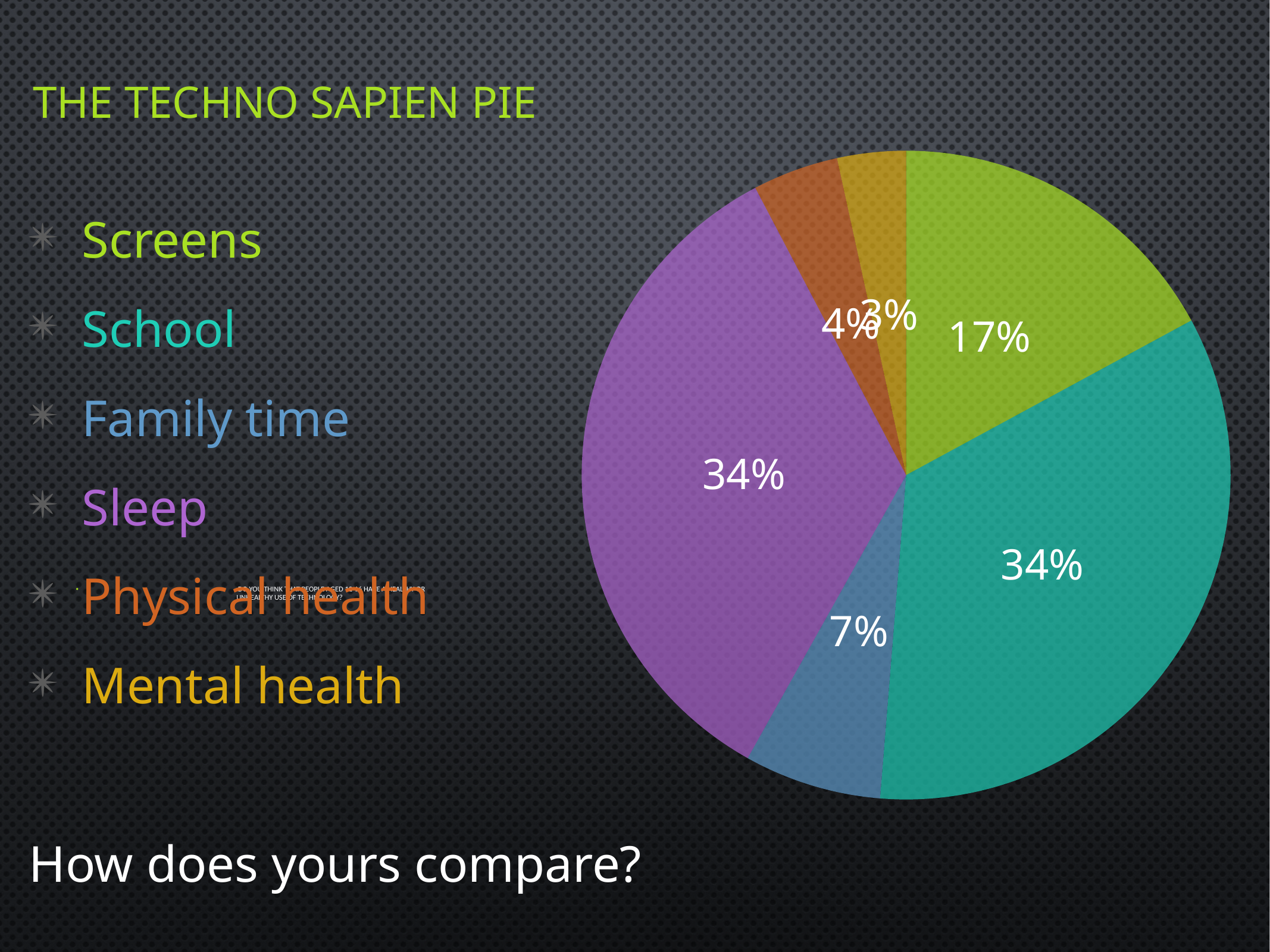
What is the difference between the Screens share and the Physical health share? 13% What kind of chart is shown on the slide? pie chart What share of the pie is Physical health? 4% Which is larger, the Screens slice or the Family time slice? Screens What is the difference between the School share and the Family time share? 27% What share of the pie is Screens? 17% What share of the pie is Family time? 7% What share of the pie is Sleep? 34% What share of the pie is School? 34% How many categories does the pie chart have? 6 What colour is the Sleep slice of the pie? purple What is the title of the chart on the slide? THE TECHNO SAPIEN PIE